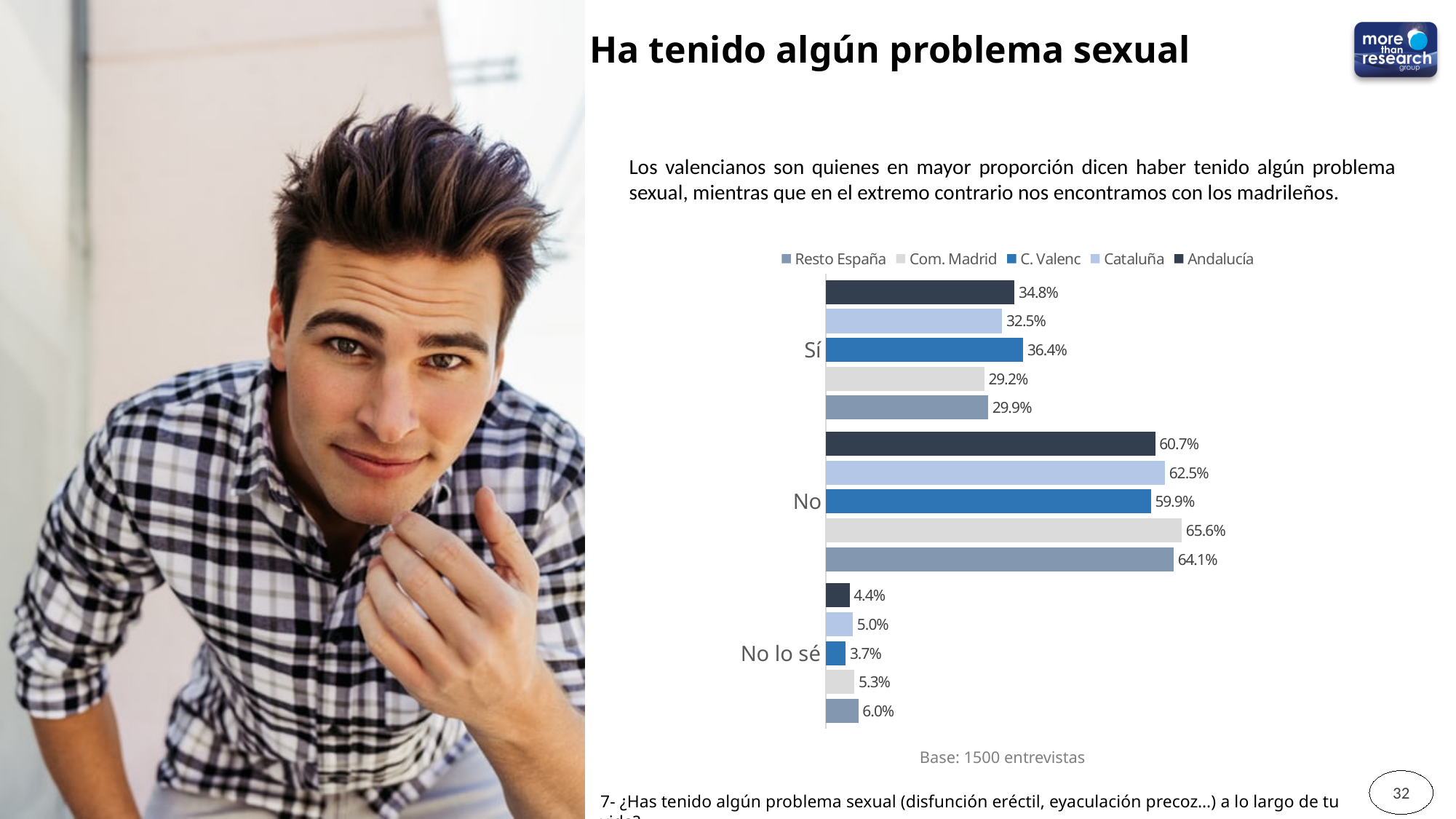
What percentage of respondents from C. Valenc answered "Sí"? 36.4% Which region has the lowest value in the "Sí" category? Com. Madrid What percentage of Resto España respondents answered "No lo sé"? 6.0% How many response categories are shown on the chart? 3 What kind of chart is shown on the slide? Bar chart How many series does the legend list? 5 What is the difference between Com. Madrid and C. Valenc in the "No" category? 5.7% What is the value for Com. Madrid in the "No" category? 65.6% Which region has the highest value in the "Sí" category? C. Valenc What is the value for Andalucía in the "Sí" category? 34.8% In the "Sí" category, which is larger: Cataluña or Resto España? Cataluña Which region has the lowest value in the "No lo sé" category? C. Valenc